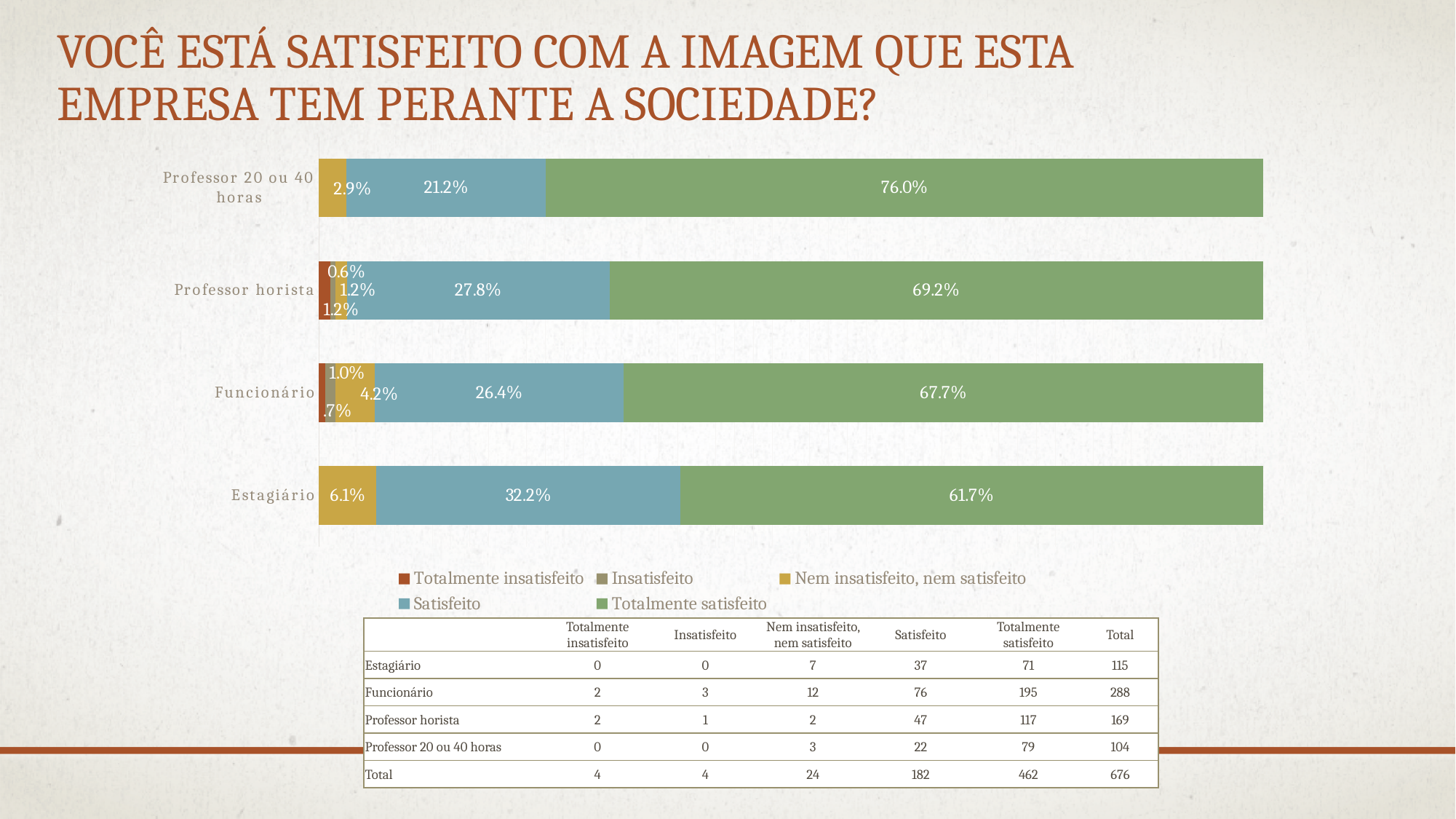
What is the difference between the 'Satisfeito' values for 'Estagiário' and 'Professor 20 ou 40 horas'? 11.0 percentage points Which colour represents 'Totalmente satisfeito' in the legend? Green What is the 'Totalmente satisfeito' value for 'Funcionário'? 67.7% What is the 'Nem insatisfeito, nem satisfeito' value for 'Estagiário'? 6.1% What kind of chart is shown on the slide? Stacked bar chart How many series does the legend list? 5 How many categories (bars) are shown in the chart? 4 Which category has the highest 'Totalmente satisfeito' percentage? Professor 20 ou 40 horas What is the 'Satisfeito' value for 'Estagiário'? 32.2% What percentage of 'Professor 20 ou 40 horas' respondents are 'Totalmente satisfeito'? 76.0% Which has a larger 'Satisfeito' share, 'Professor horista' or 'Funcionário'? Professor horista Which category has the lowest 'Totalmente satisfeito' percentage? Estagiário